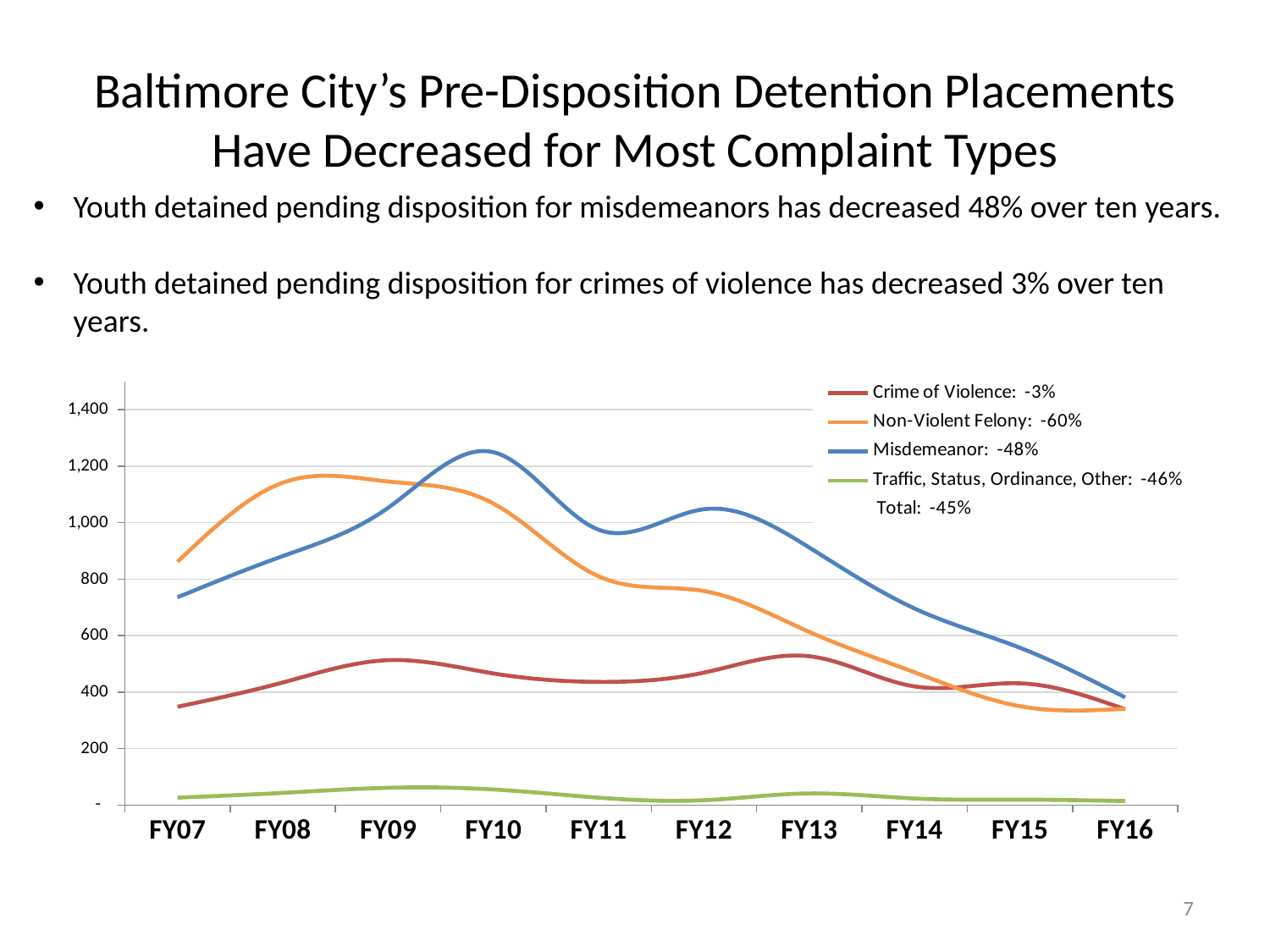
How many series does the chart legend list (excluding the Total note)? 4 Is the Crime of Violence value in FY07 greater or less than 400? less Is the Traffic, Status, Ordinance, Other value in FY16 greater or less than 200? less How many fiscal years are plotted along the x axis? 10 Is the Misdemeanor value in FY10 greater or less than 1,200? greater Which series has the lowest values across all fiscal years? Traffic, Status, Ordinance, Other What kind of chart is shown on the slide? line chart Does the Non-Violent Felony line rise or fall from FY08 to FY16? fall In FY13, which is larger: Misdemeanor or Non-Violent Felony? Misdemeanor Which series has the highest value in FY10? Misdemeanor In FY08, which is larger: Non-Violent Felony or Misdemeanor? Non-Violent Felony